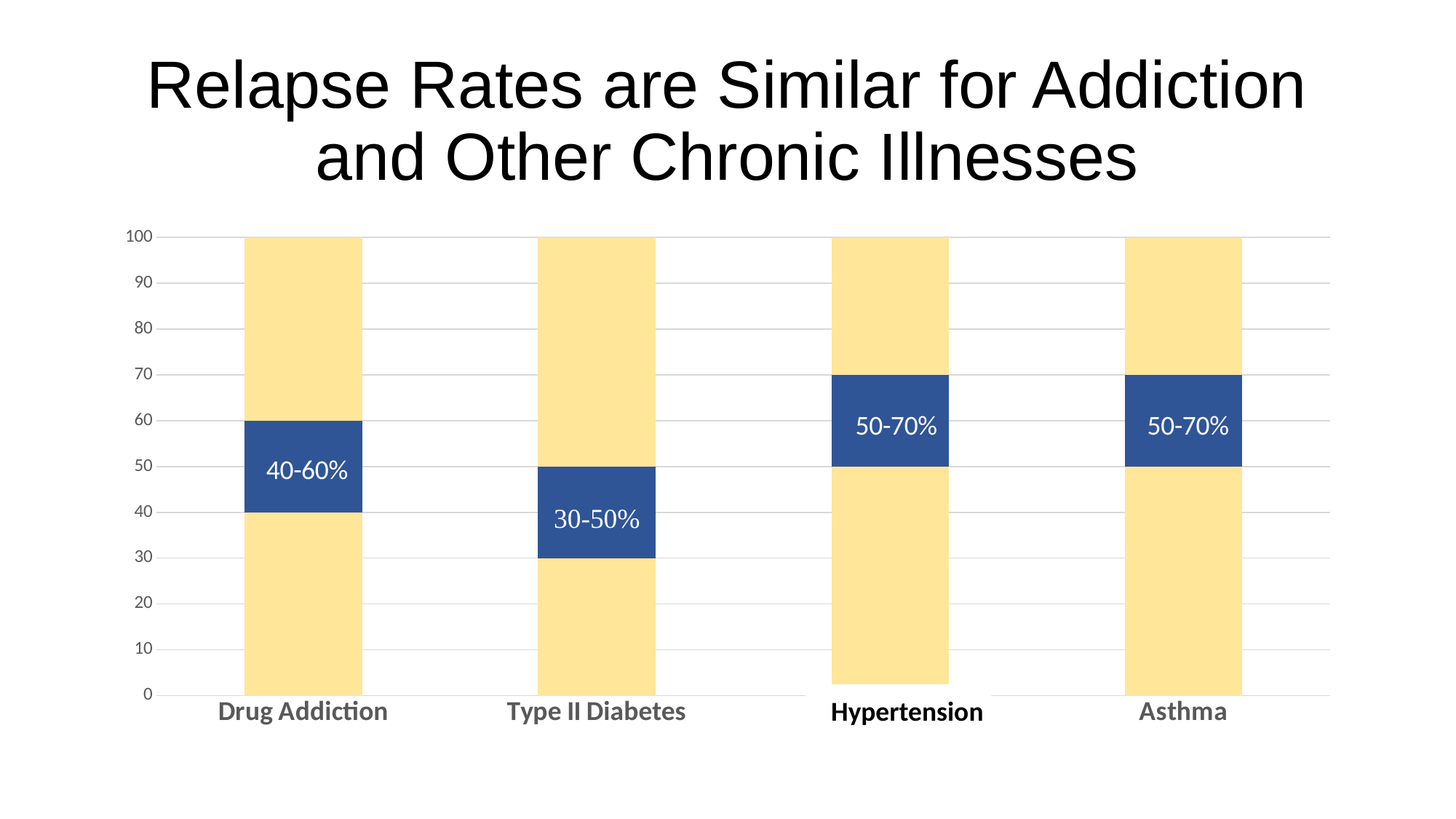
Is the upper end of the relapse rate range for Hypertension greater or less than 60? greater What relapse rate range is shown for Type II Diabetes? 30-50% Which has the higher relapse rate range, Drug Addiction or Type II Diabetes? Drug Addiction What relapse rate range is shown for Drug Addiction? 40-60% What relapse rate range is shown for Hypertension? 50-70% Which condition has the lowest relapse rate range on the chart? Type II Diabetes What relapse rate range is shown for Asthma? 50-70% What kind of chart is shown on the slide? Bar chart What is the title of the slide? Relapse Rates are Similar for Addiction and Other Chronic Illnesses How many conditions are shown on the x axis of the chart? 4 Is the lower end of the relapse rate range for Type II Diabetes greater or less than 40? less What colour is used to highlight the relapse rate range within each bar? Blue